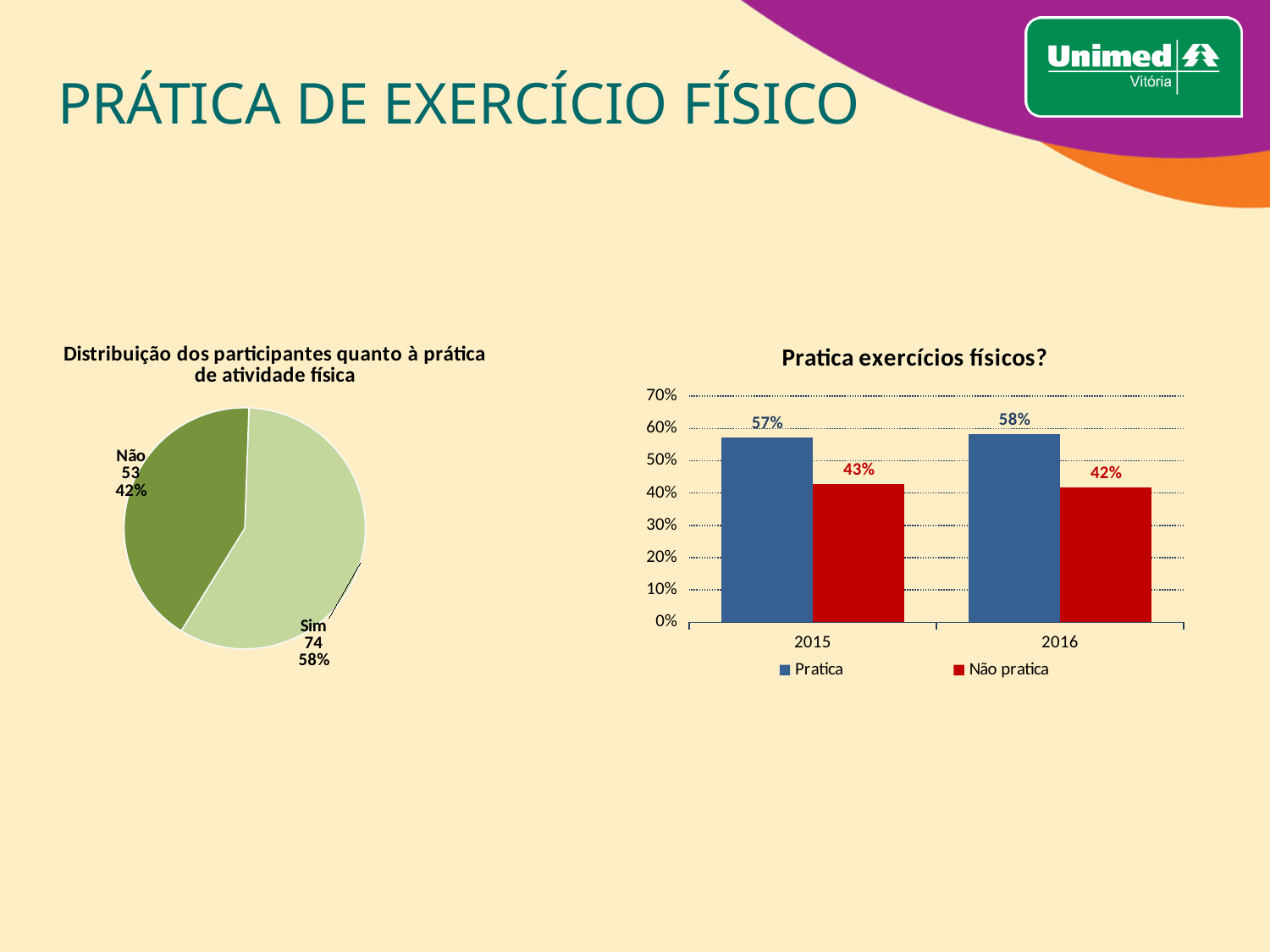
In the chart 'Pratica exercícios físicos?', does the 'Pratica' series rise or fall from 2015 to 2016? Rise In the pie chart 'Distribuição dos participantes quanto à prática de atividade física', what is the total number of participants across both slices? 127 In the chart 'Pratica exercícios físicos?', what kind of chart is it? Bar chart In the pie chart 'Distribuição dos participantes quanto à prática de atividade física', how many participants answered 'Sim'? 74 In the chart 'Pratica exercícios físicos?', what is the value for 'Pratica' in 2016? 58% In the chart 'Pratica exercícios físicos?', what is the difference between 'Pratica' and 'Não pratica' in 2016? 16% In the pie chart 'Distribuição dos participantes quanto à prática de atividade física', which slice is larger, 'Sim' or 'Não'? Sim In the chart 'Pratica exercícios físicos?', how many series does the legend list? 2 In the chart 'Pratica exercícios físicos?', what colour are the 'Não pratica' bars? Red In the pie chart 'Distribuição dos participantes quanto à prática de atividade física', what percentage share does the 'Não' slice have? 42% In the chart 'Pratica exercícios físicos?', what is the value for 'Não pratica' in 2015? 43% In the pie chart 'Distribuição dos participantes quanto à prática de atividade física', how many slices are there? 2